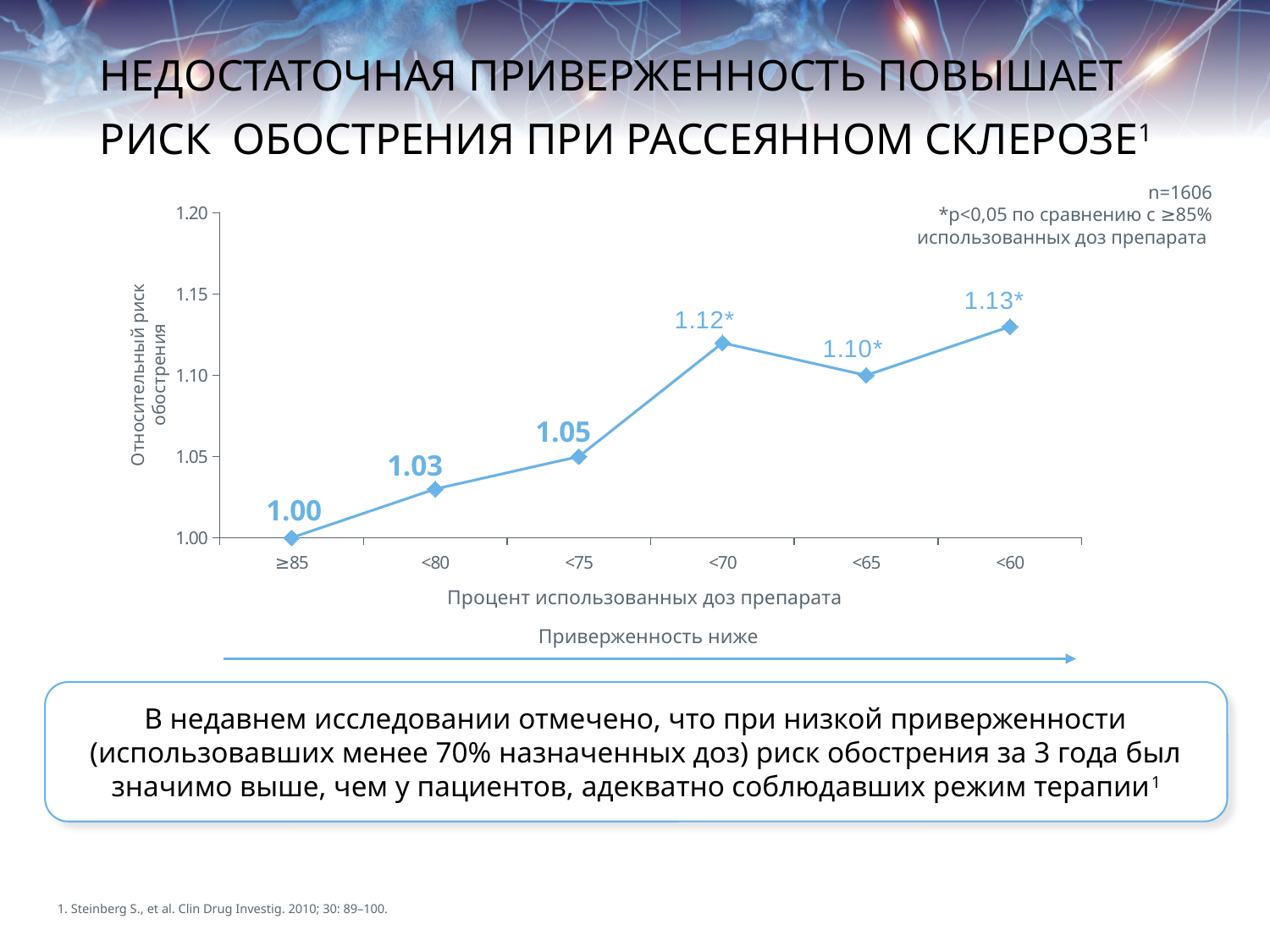
How many categories are plotted along the x axis of the chart? 6 Which category on the x axis has the highest relative risk of exacerbation? <60 What is the relative risk of exacerbation (Относительный риск обострения) for the ≥85 category? 1.00 What is the difference between the relative risk for <60 and the relative risk for ≥85? 0.13 Is the value for <65 greater or less than 1.05? greater What is the relative risk value plotted for the <80 category? 1.03 Which category has the larger relative risk value: <70 or <65? <70 Do the plotted values generally rise or fall moving from ≥85 to <60 along the x axis? rise What is the relative risk value plotted for the <70 category? 1.12 What is the label of the x axis of the chart? Процент использованных доз препарата What kind of chart is shown on the slide? line chart Which category on the x axis has the lowest relative risk of exacerbation? ≥85